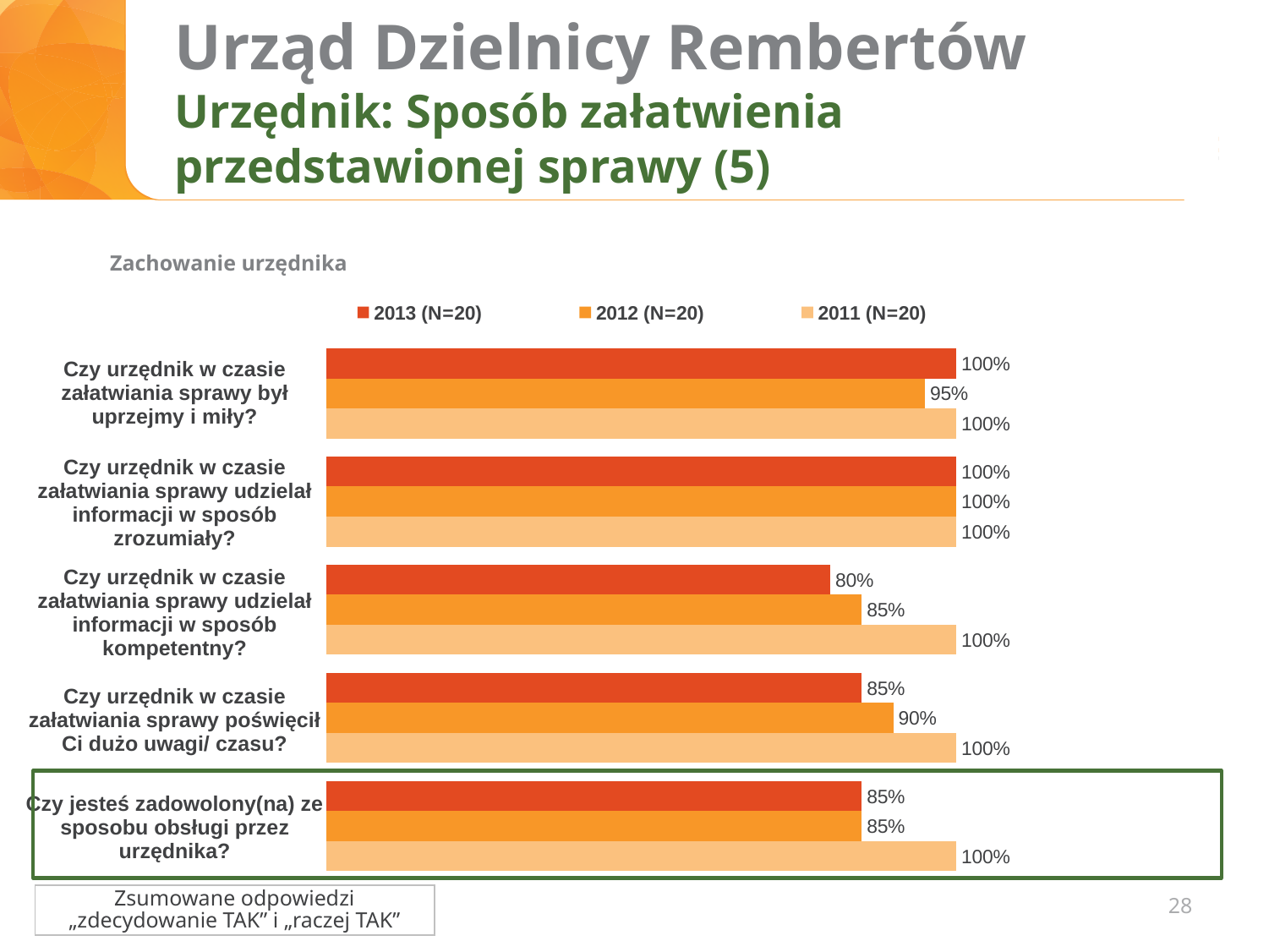
What is the 2013 (N=20) value for "Czy urzędnik w czasie załatwiania sprawy udzielał informacji w sposób kompetentny?"? 80% What is the title shown above the chart? Zachowanie urzędnika What kind of chart is shown on the slide? bar chart How many series does the legend list? 3 What is the 2012 (N=20) value for "Czy urzędnik w czasie załatwiania sprawy poświęcił Ci dużo uwagi/ czasu?"? 90% How many question categories are plotted on the chart? 5 Which category has the lowest 2013 (N=20) value? Czy urzędnik w czasie załatwiania sprawy udzielał informacji w sposób kompetentny? What is the difference between the 2011 (N=20) and 2013 (N=20) values for "Czy urzędnik w czasie załatwiania sprawy udzielał informacji w sposób kompetentny?"? 20% For "Czy urzędnik w czasie załatwiania sprawy poświęcił Ci dużo uwagi/ czasu?", which is larger: the 2012 (N=20) value or the 2013 (N=20) value? 2012 (N=20) What is the 2012 (N=20) value for "Czy urzędnik w czasie załatwiania sprawy był uprzejmy i miły?"? 95% What is the 2011 (N=20) value for "Czy jesteś zadowolony(na) ze sposobu obsługi przez urzędnika?"? 100% Which series is shown in the darkest red-orange colour? 2013 (N=20)